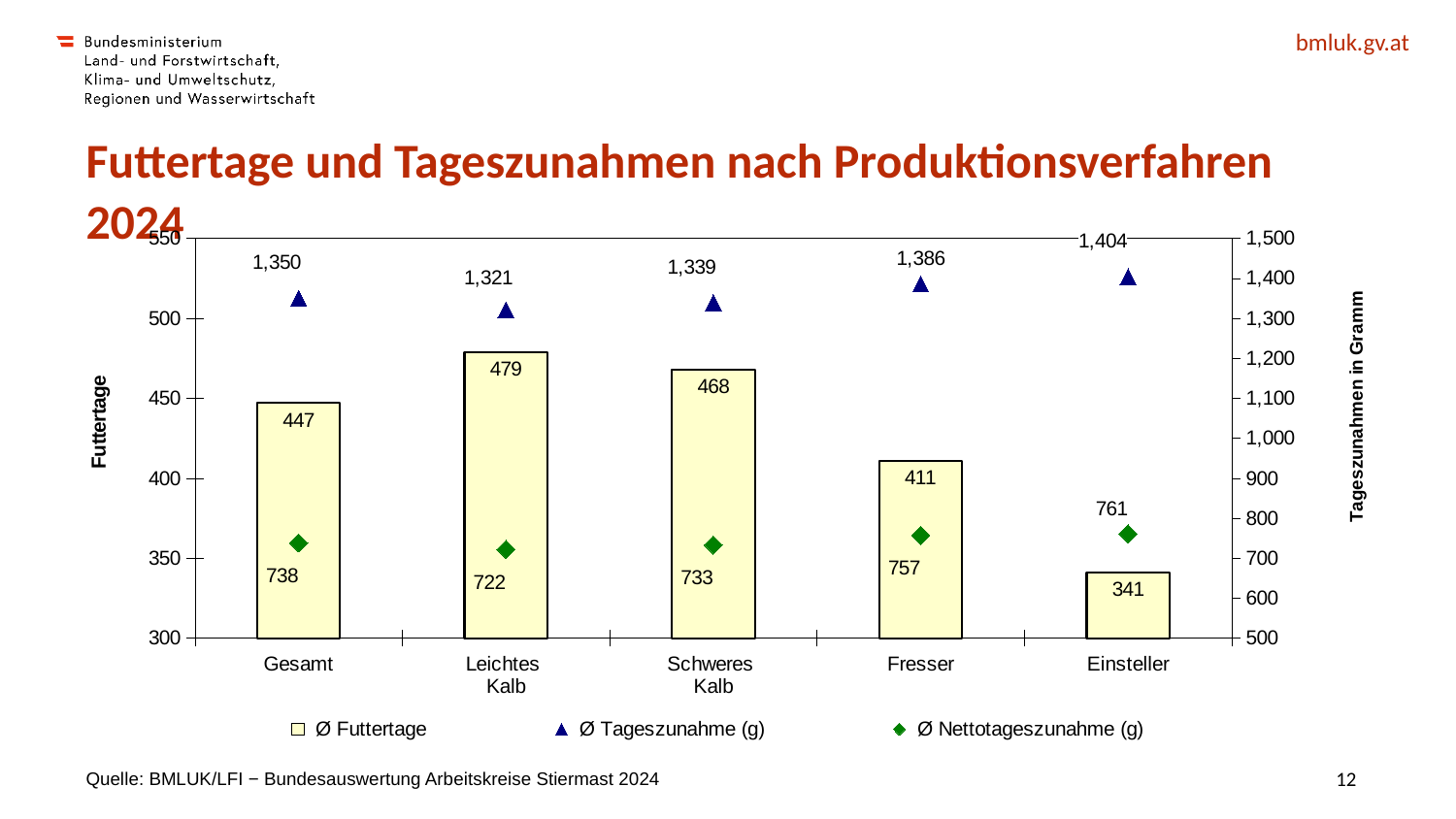
How many categories are shown on the x axis? 5 What is the Ø Nettotageszunahme (g) value for Gesamt? 738 What is the difference between the Ø Tageszunahme (g) for Einsteller and for Leichtes Kalb? 83 How many series does the legend list? 3 What is the Ø Tageszunahme (g) value for Fresser? 1,386 Which category has the highest Ø Tageszunahme (g) value? Einsteller What is the label of the right-hand vertical axis? Tageszunahmen in Gramm What is the Ø Futtertage value for Leichtes Kalb? 479 Which is larger, the Ø Nettotageszunahme (g) for Fresser or for Leichtes Kalb? Fresser What is the difference in Ø Futtertage between Gesamt and Einsteller? 106 Which category has the lowest Ø Futtertage value? Einsteller Which category has the highest Ø Futtertage value? Leichtes Kalb